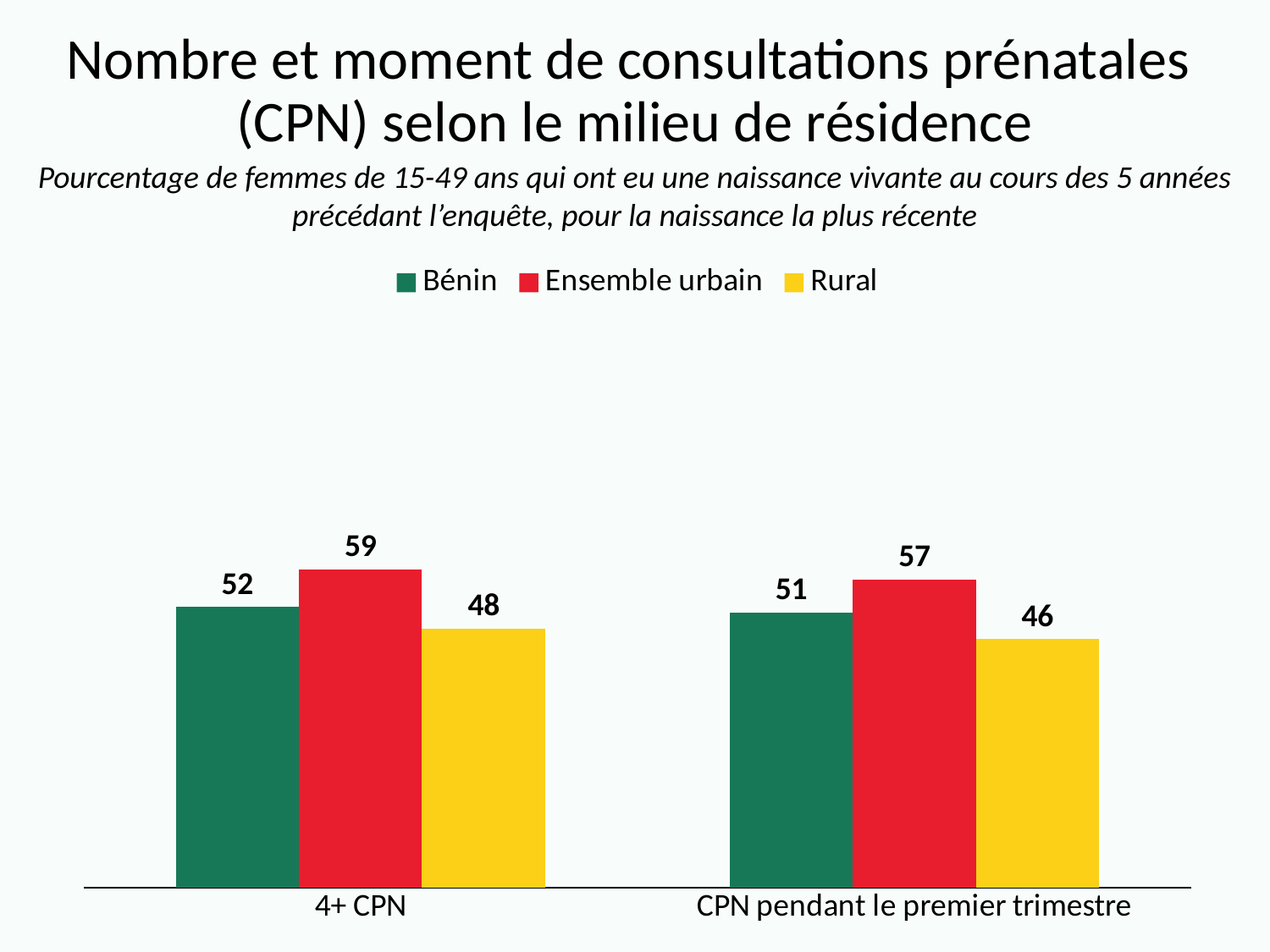
What is the value for Ensemble urbain in the 4+ CPN category? 59 How many categories are shown on the x axis? 2 How many series does the legend list? 3 What is the value for Bénin in the 4+ CPN category? 52 Which is larger: Bénin for 4+ CPN or Bénin for CPN pendant le premier trimestre? Bénin for 4+ CPN Which series has the highest value in the CPN pendant le premier trimestre category? Ensemble urbain What is the difference between Ensemble urbain and Rural in the 4+ CPN category? 11 What is the difference between Bénin and Rural in the CPN pendant le premier trimestre category? 5 What kind of chart is shown on the slide? Bar chart Which colour represents the Rural series? Yellow Which series has the lowest value in the 4+ CPN category? Rural What is the value for Rural in the CPN pendant le premier trimestre category? 46